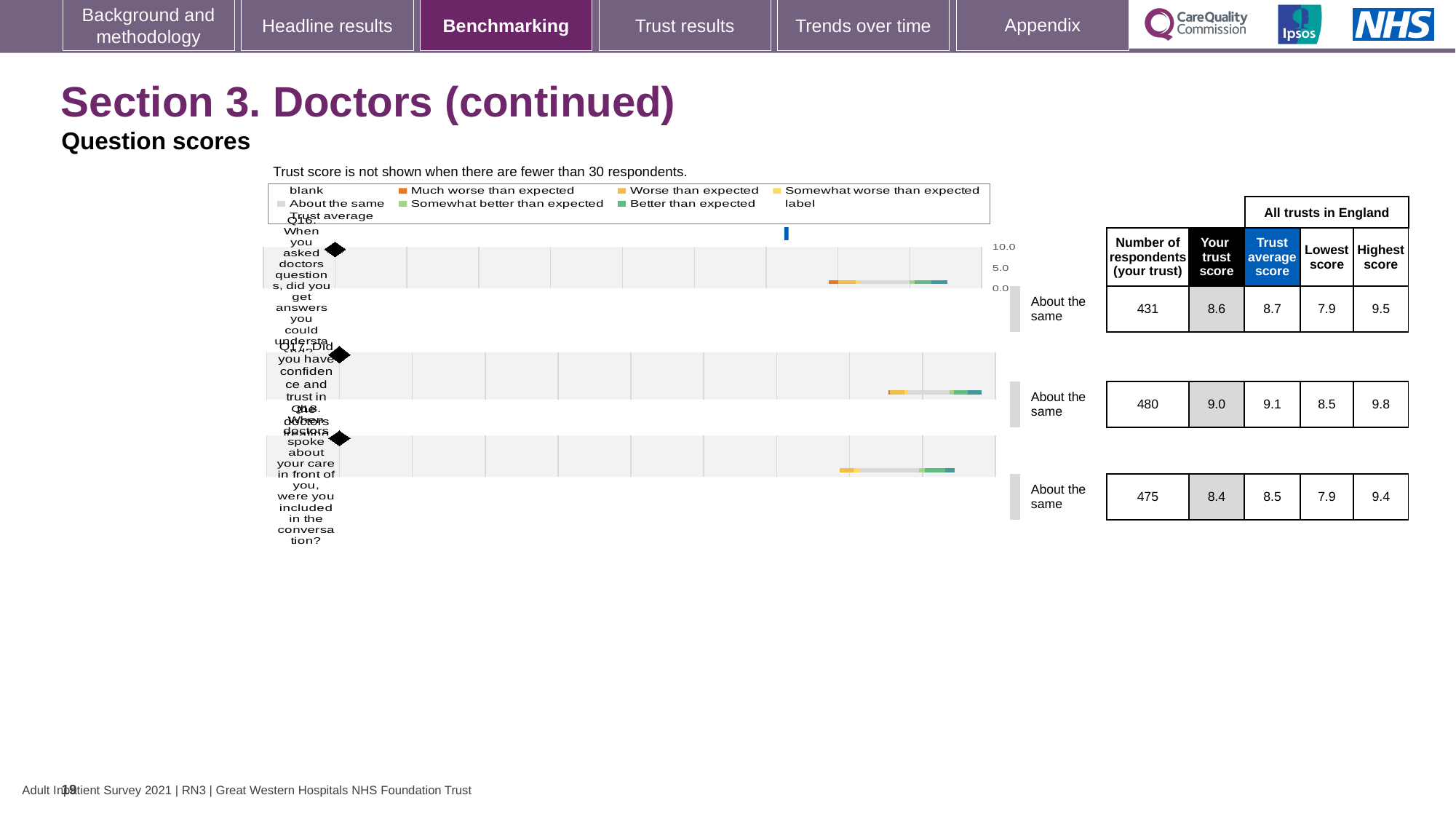
What kind of chart is used to show the question scores on this slide? bar chart How many questions are plotted in the chart? 3 What is the difference between the highest score and the lowest score for Q17? 1.3 Which of the three questions has the highest trust score? Q17 What is the trust average score for Q17? 9.1 What is the trust score for Q18 (When doctors spoke about your care in front of you, were you included in the conversation)? 8.4 What is the trust score for Q16 (When you asked doctors questions, did you get answers you could understand)? 8.6 Is the trust score for Q17 greater or less than 5.0? greater What benchmark category is shown for all three questions? About the same Which of the three questions has the lowest trust score? Q18 Which has the larger trust score, Q16 or Q18? Q16 What is the trust score for Q17 (Did you have confidence and trust in the doctors treating you)? 9.0